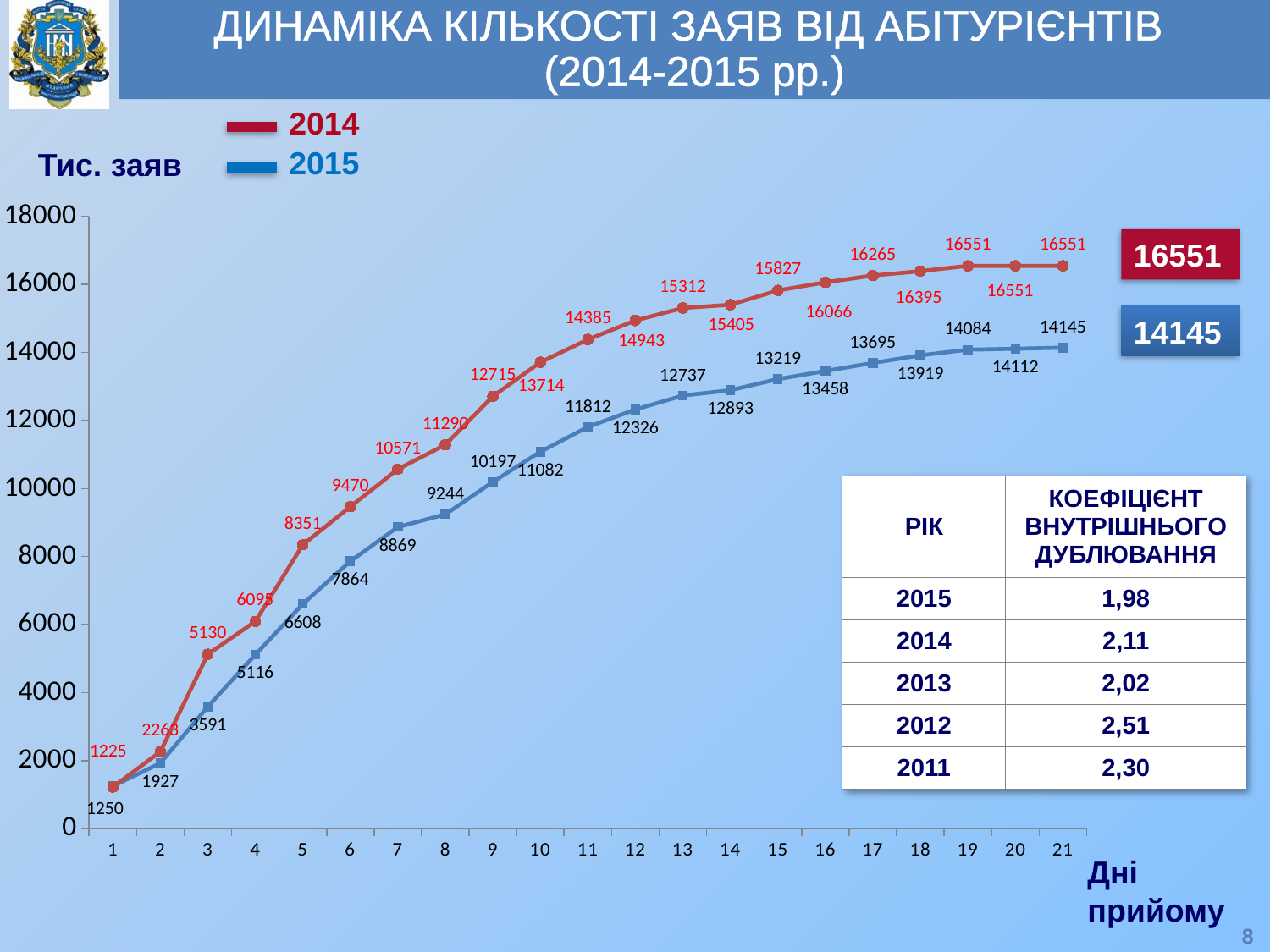
What is the value for 2015 on day 8? 9244 What is the value for 2015 on day 21? 14145 What kind of chart is shown on the slide? line chart How many series does the legend list? 2 What is the difference between the 2014 and 2015 values on day 10? 2632 What is the value for 2014 on day 21? 16551 What is the value for 2014 on day 10? 13714 What is the value for 2015 on day 1? 1250 On which day does the 2015 series reach its highest value? 21 How many days are plotted on the x axis? 21 What is the difference between the 2014 and 2015 values on day 21? 2406 On day 1, which series has the larger value, 2014 or 2015? 2015